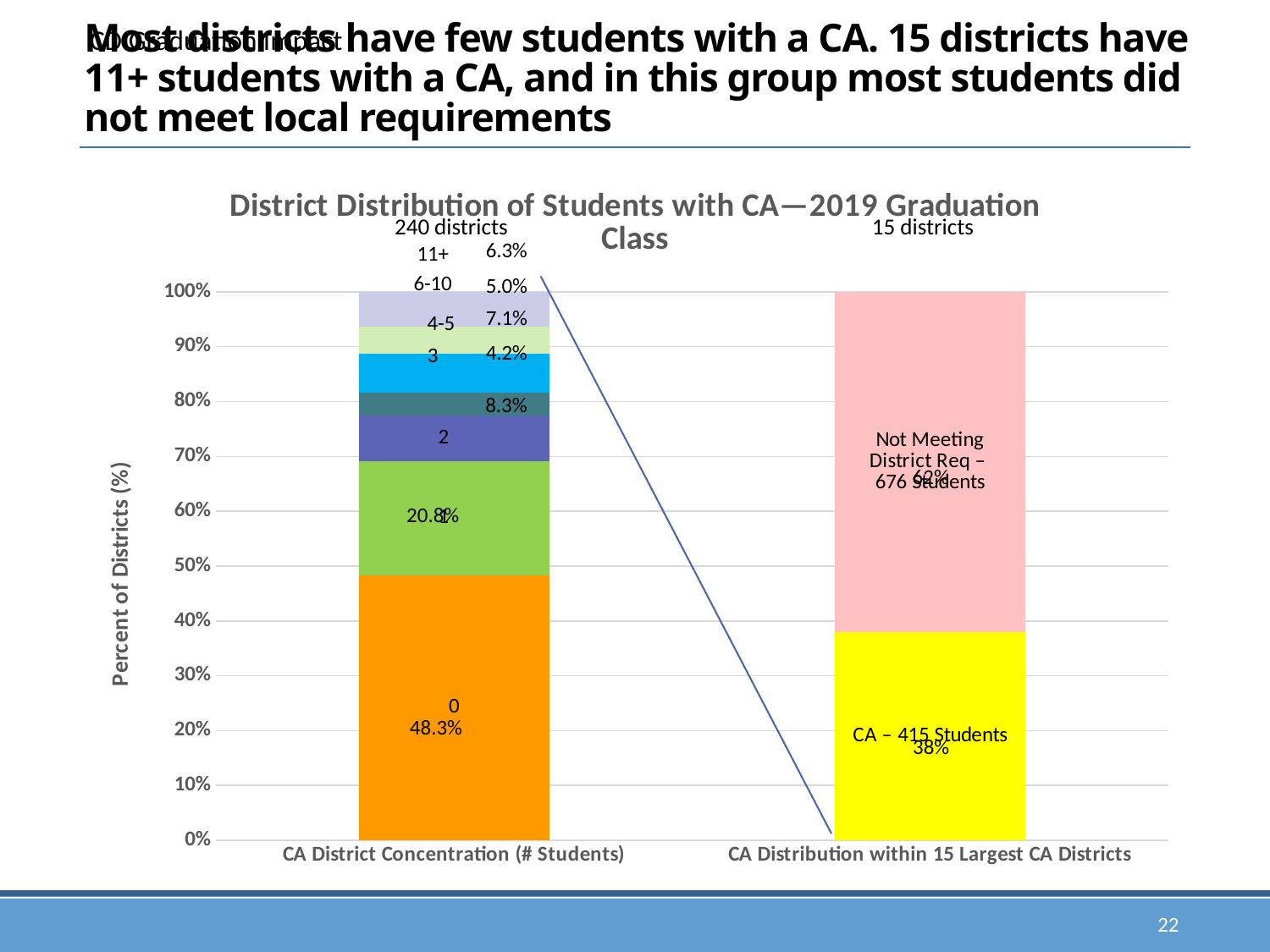
In the CA District Concentration bar, what percentage of districts have 11+ students with a CA? 6.3% What type of chart is shown on the slide? Stacked bar chart How many students are in the CA segment of the 15 Largest CA Districts bar? 415 In the CA District Concentration bar, what percentage of districts have 3 students with a CA? 4.2% In the CA Distribution within 15 Largest CA Districts bar, what percentage of students are Not Meeting District Req? 62% Is the share of districts with 0 students with a CA greater or less than 40%? greater In the CA District Concentration bar, which category has the largest share of districts? 0 In the CA District Concentration bar, which category has the smallest share of districts? 3 In the CA District Concentration bar, what percentage of districts have 4-5 students with a CA? 7.1% What is the label of the y axis? Percent of Districts (%) What is the title of the chart? District Distribution of Students with CA—2019 Graduation Class In the CA District Concentration bar, what percentage of districts have 0 students with a CA? 48.3%